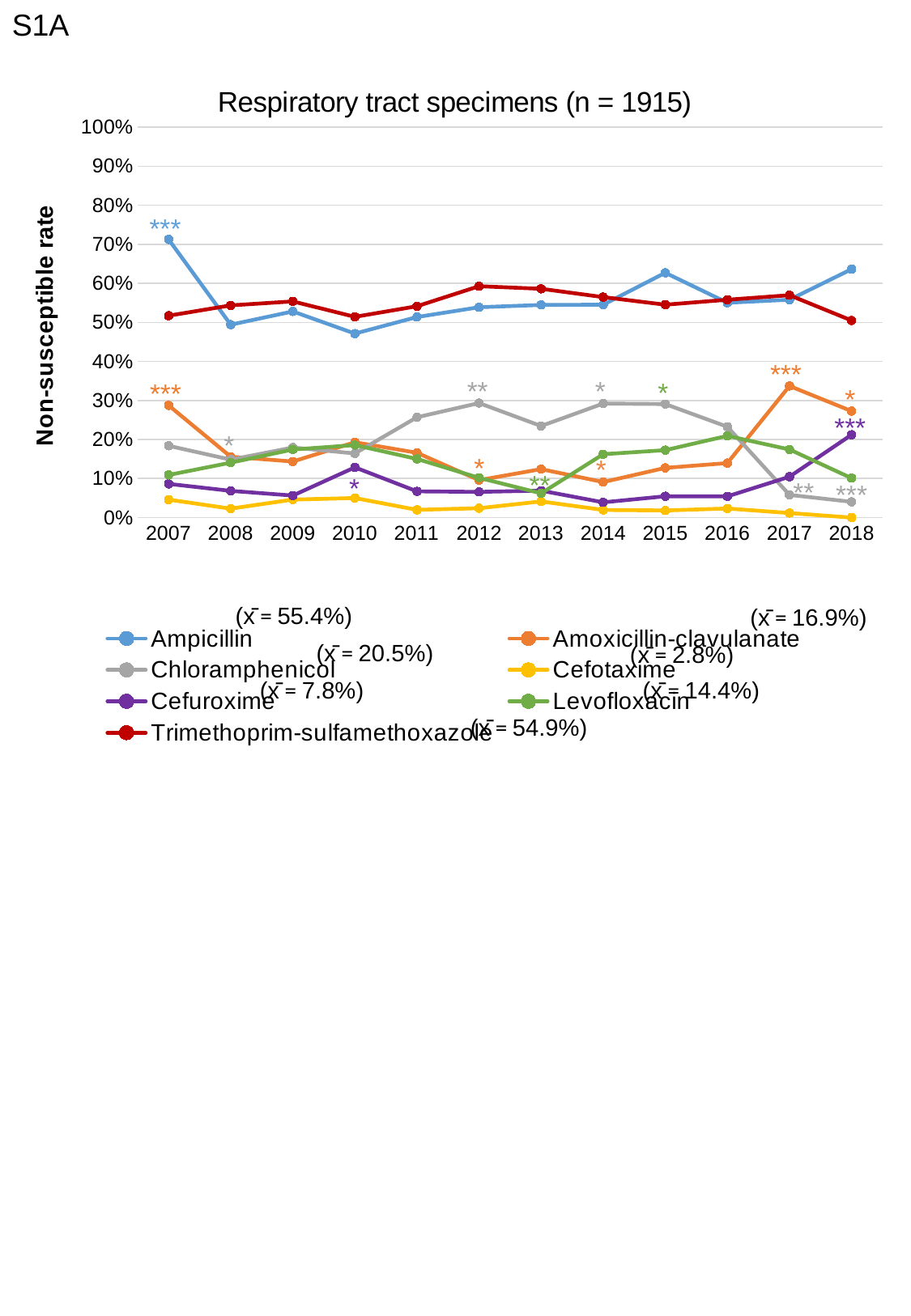
How many series does the legend list? 7 Which series has the highest non-susceptible rate in 2007? Ampicillin Is the value for Ampicillin in 2007 greater or less than 70%? greater How many years are plotted along the x axis? 12 What is the title of the chart? Respiratory tract specimens (n = 1915) Is the value for Amoxicillin-clavulanate in 2017 greater or less than 30%? greater What kind of chart is shown on the slide? line chart Does the Chloramphenicol line rise or fall from 2016 to 2018? fall In 2010, which is larger: the value for Ampicillin or the value for Trimethoprim-sulfamethoxazole? Trimethoprim-sulfamethoxazole According to the legend, what is the mean non-susceptible rate for Ampicillin? 55.4% Is the value for Chloramphenicol in 2012 greater or less than 20%? greater Which series has the lowest non-susceptible rate in 2018? Cefotaxime